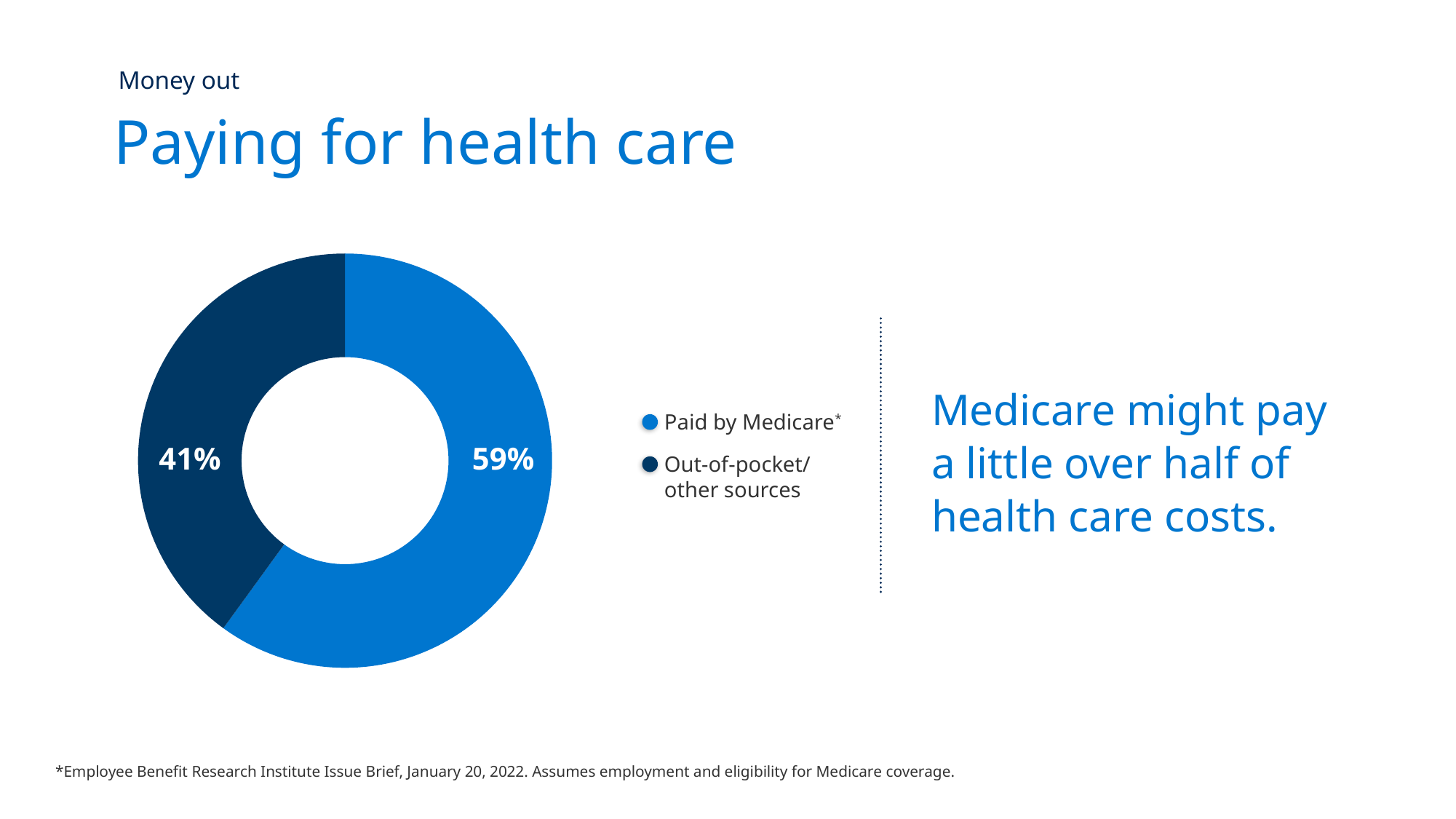
Is the share paid by Medicare larger or smaller than the share from out-of-pocket/other sources? larger How many slices does the pie chart have? 2 Which category has the larger share of the pie? Paid by Medicare What kind of chart is shown on the slide? Pie chart (donut) How many entries does the legend list? 2 What is the title of the slide containing the chart? Paying for health care What is the total of the two slices shown in the pie chart? 100% Which category has the smaller share of the pie? Out-of-pocket/other sources What colour is the slice for Paid by Medicare? Light blue What is the difference in percentage points between the Medicare share and the out-of-pocket/other sources share? 18 What share of health care costs is paid by Medicare? 59% What share of health care costs comes from out-of-pocket/other sources? 41%